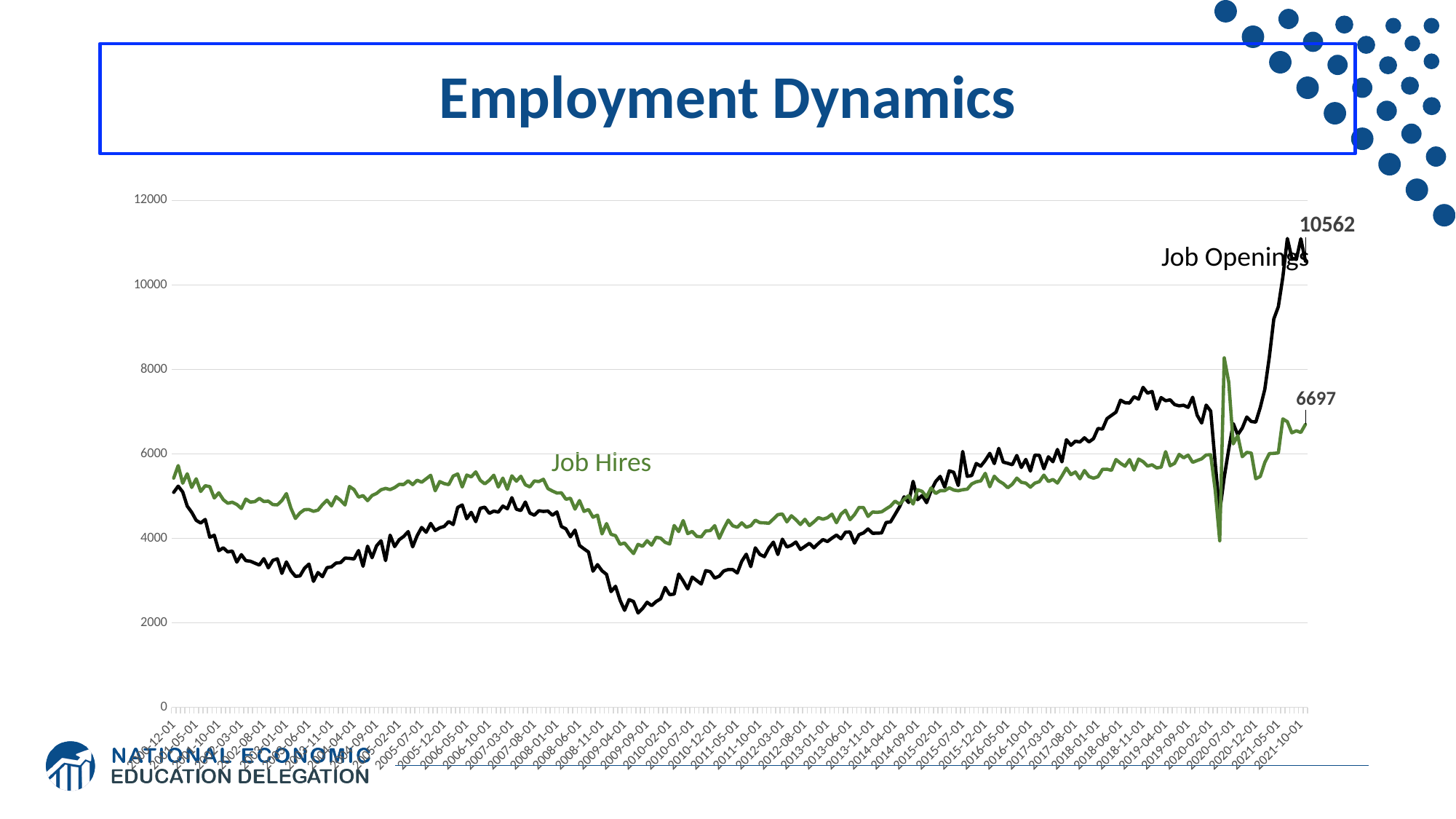
What is the final labelled value of the Job Hires series? 6697 Is the value of Job Hires at 2005-12-01 greater or less than 4000? greater What is the final labelled value of the Job Openings series? 10562 How many data series are plotted on the chart? 2 What colour is the Job Hires line? green What kind of chart is shown on the slide? line chart At the end of the series, which is larger: Job Openings or Job Hires? Job Openings What is the title of the chart? Employment Dynamics Is the value of Job Openings at 2018-11-01 greater or less than 6000? greater Does the Job Openings series rise or fall between 2008-01-01 and 2009-09-01? fall What is the difference between the final labelled values of Job Openings and Job Hires? 3865 Is the value of Job Openings at 2009-09-01 greater or less than 4000? less